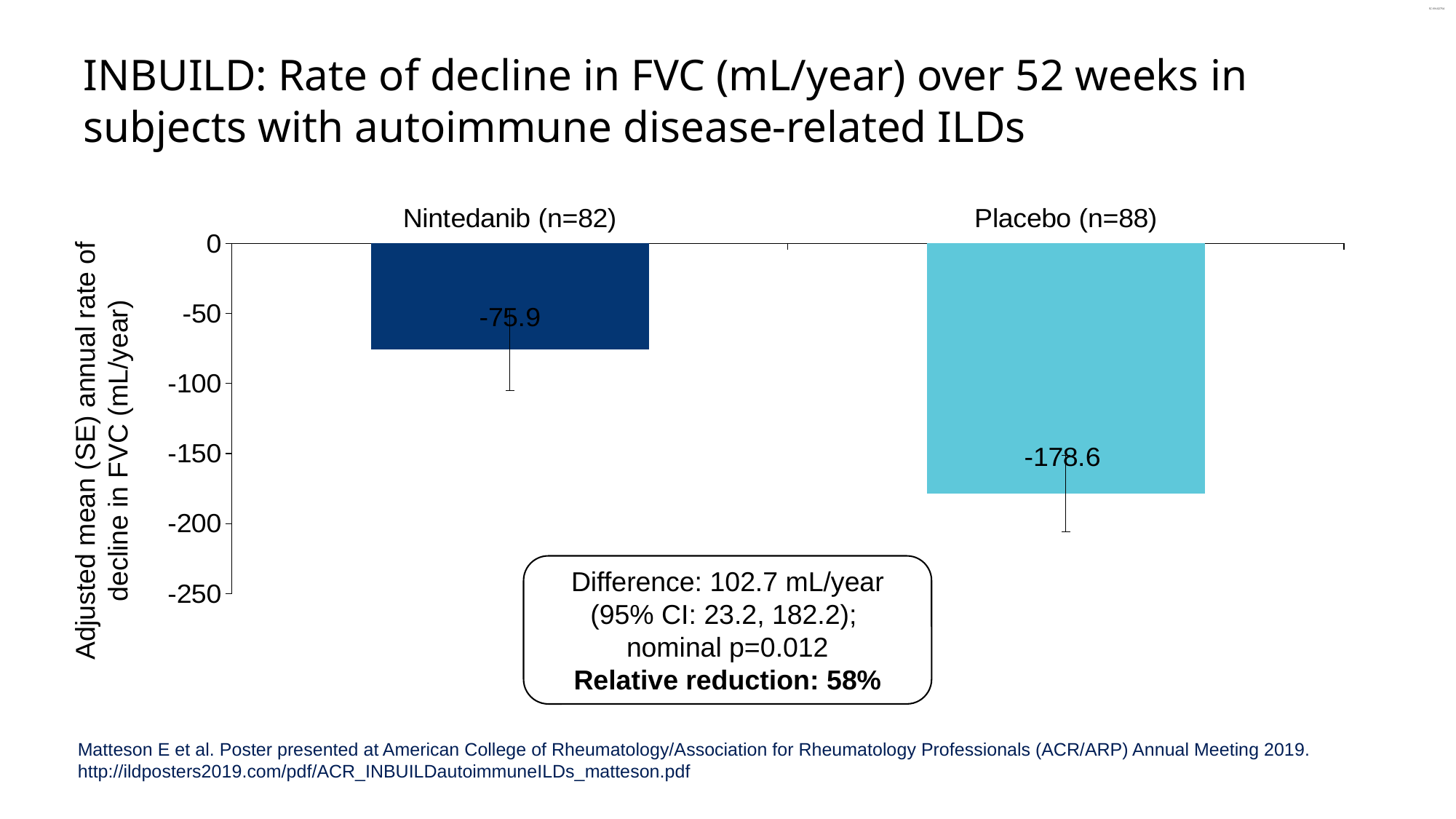
What kind of chart is shown on the slide? Bar chart Which group shows the larger decline in FVC, Nintedanib or Placebo? Placebo Which group has the lowest (most negative) value on the chart? Placebo (n=88) Is the value for Nintedanib (n=82) greater or less than -100? greater What relative reduction is stated in the box on the chart? 58% What is the adjusted mean annual rate of decline in FVC for Nintedanib (n=82)? -75.9 What is the adjusted mean annual rate of decline in FVC for Placebo (n=88)? -178.6 How many groups (bars) are plotted on the chart? 2 What is the label of the y axis? Adjusted mean (SE) annual rate of decline in FVC (mL/year) Is the value for Placebo (n=88) greater or less than -150? less Which group has the highest (least negative) value on the chart? Nintedanib (n=82) What is the difference between the Placebo and Nintedanib values shown on the chart? 102.7